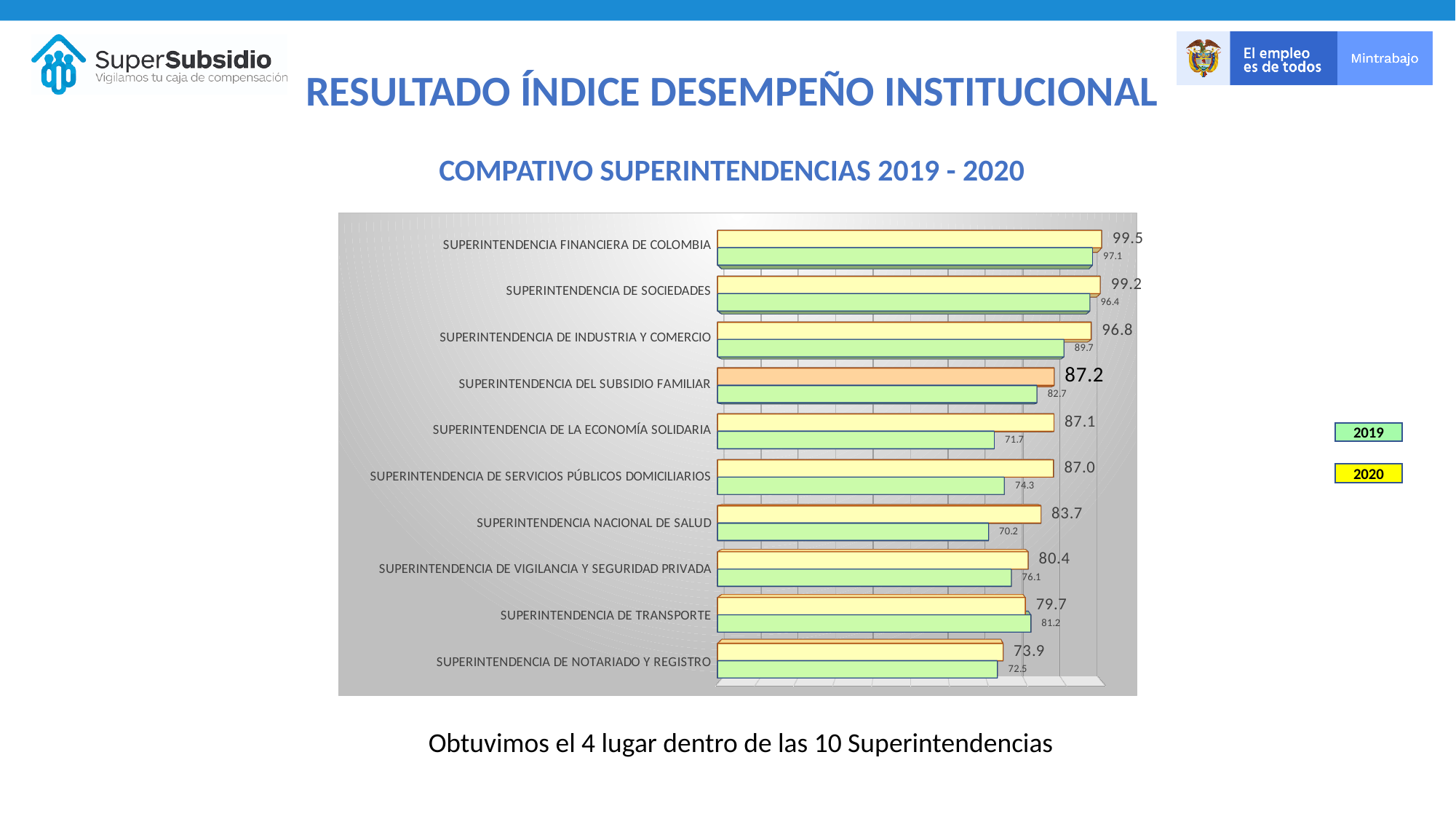
What is the difference between the 2020 and 2019 values for Superintendencia de la Economía Solidaria? 15.4 Which superintendencia has the lowest 2019 value? Superintendencia Nacional de Salud What is the 2020 value for Superintendencia del Subsidio Familiar? 87.2 How many series does the legend list? 2 Which superintendencia has the highest 2020 value? Superintendencia Financiera de Colombia What is the 2019 value for Superintendencia de Industria y Comercio? 89.7 How many superintendencias are listed in the chart? 10 What is the 2020 value for Superintendencia Nacional de Salud? 83.7 What kind of chart is shown on the slide? Bar chart For Superintendencia de Transporte, which year has the larger value, 2019 or 2020? 2019 Which colour represents the 2020 series in the chart? Yellow What is the 2019 value for Superintendencia de Notariado y Registro? 72.5